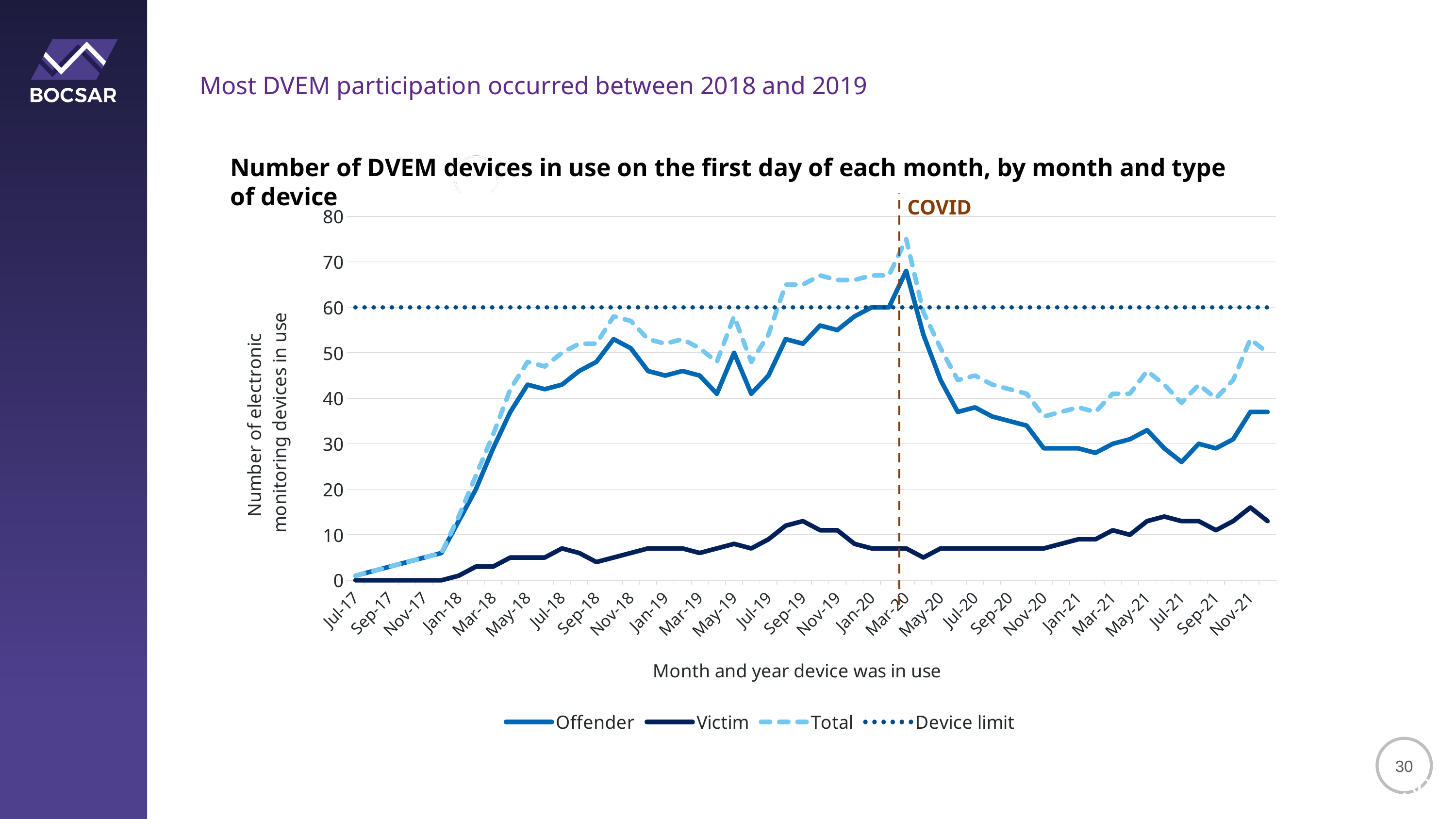
What event does the vertical dashed line on the chart mark? COVID How many series does the legend list? 4 Is the value for Total in Mar-20 greater or less than 70? greater Is the value for Offender in Mar-20 greater or less than 60? greater Is the value for Victim in Nov-21 greater or less than 20? less In Jan-19, which is larger: the Offender value or the Victim value? Offender Which series has the lowest values across the whole period? Victim What value is the Device limit line set at? 60 What kind of chart is shown on the slide? line chart Does the Offender line rise or fall between Jan-18 and May-18? rise Does the Total line rise or fall between Mar-20 and Nov-20? fall